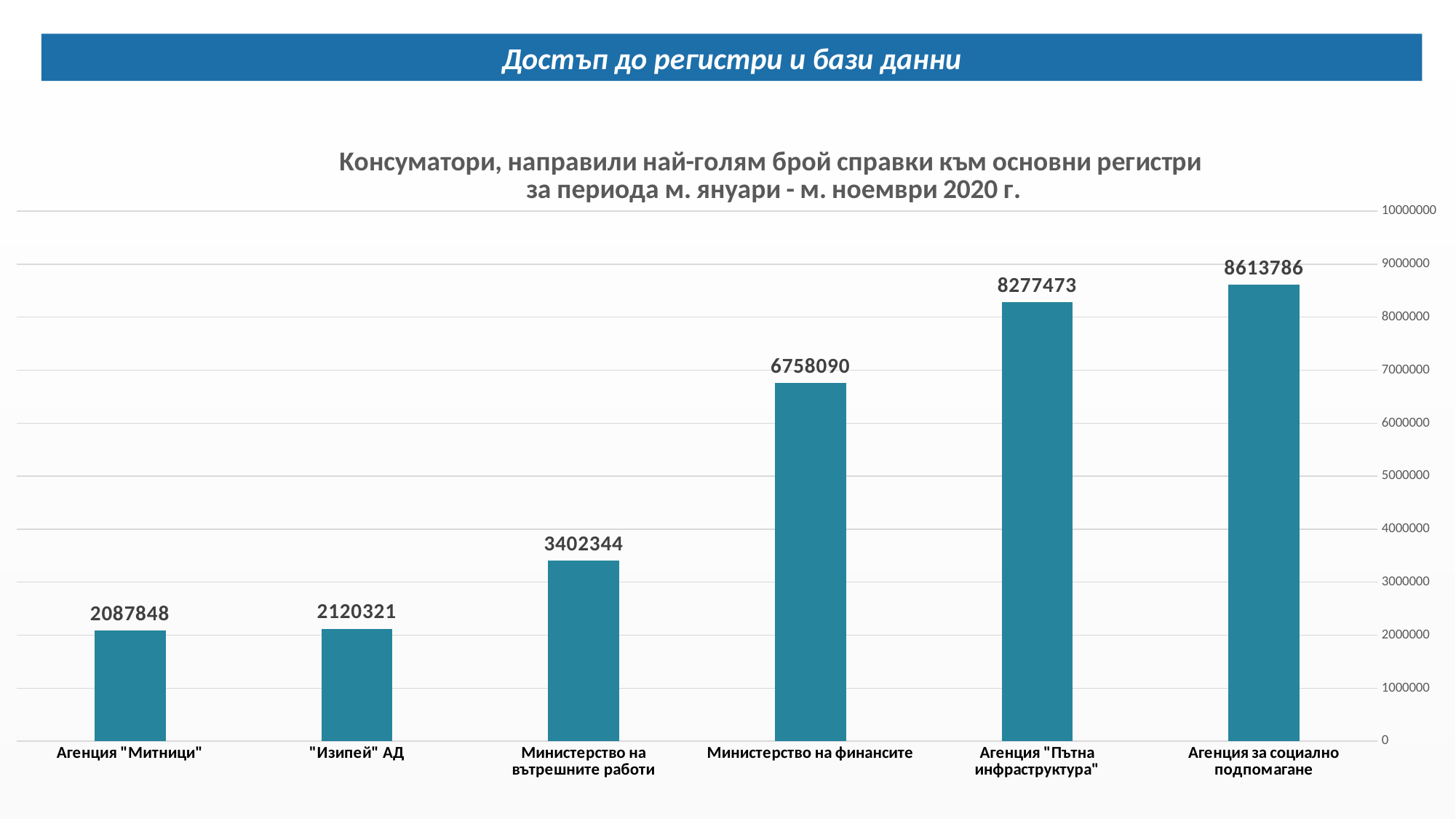
Is the value for Министерство на вътрешните работи greater or less than 4000000? less What is the value for Агенция "Митници"? 2087848 What is the value for Министерство на финансите? 6758090 What kind of chart is shown on the slide? bar chart How many categories are shown in the chart? 6 Do the values rise or fall from left to right along the x axis? rise What is the difference between the values for Агенция за социално подпомагане and Агенция "Пътна инфраструктура"? 336313 Which category has the highest value? Агенция за социално подпомагане What is the difference between the values for Министерство на финансите and Министерство на вътрешните работи? 3355746 Which category has the lowest value? Агенция "Митници" Which is larger, the value for Министерство на финансите or the value for Агенция "Пътна инфраструктура"? Агенция "Пътна инфраструктура" What is the value for Агенция за социално подпомагане? 8613786